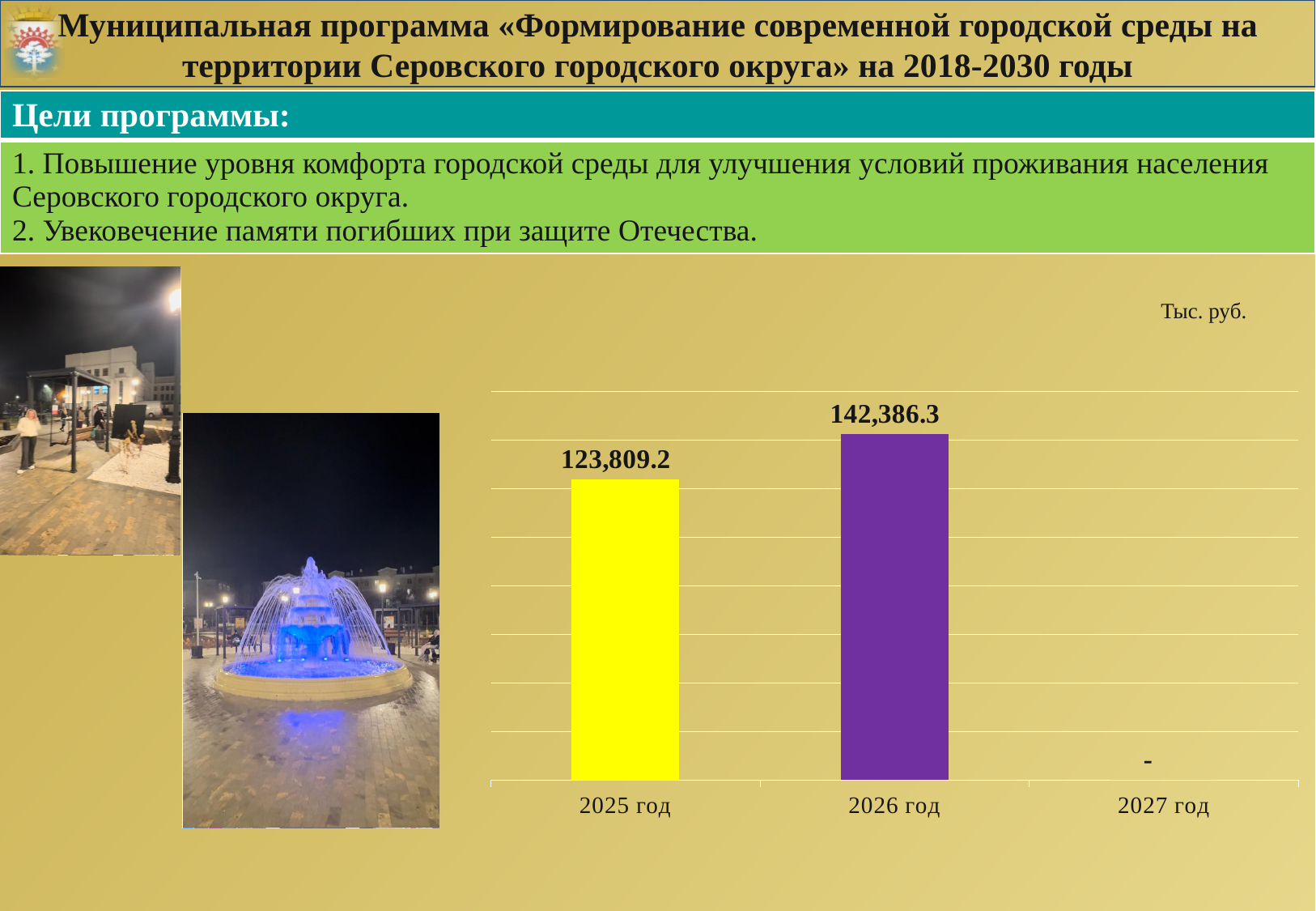
What unit is indicated for the values on the chart? Тыс. руб. Does the value rise or fall from 2025 год to 2026 год? Rise Which is larger, the value for 2025 год or the value for 2026 год? 2026 год What colour is the bar for 2026 год? Purple What is the value shown for 2025 год? 123,809.2 Which year has the highest value on the chart? 2026 год What is the value shown for 2026 год? 142,386.3 What kind of chart is shown on the slide? Bar chart What is shown as the data label for 2027 год? - What is the difference between the values for 2026 год and 2025 год? 18,577.1 How many categories are shown on the x axis of the chart? 3 Which of the two years with plotted bars has the lower value? 2025 год